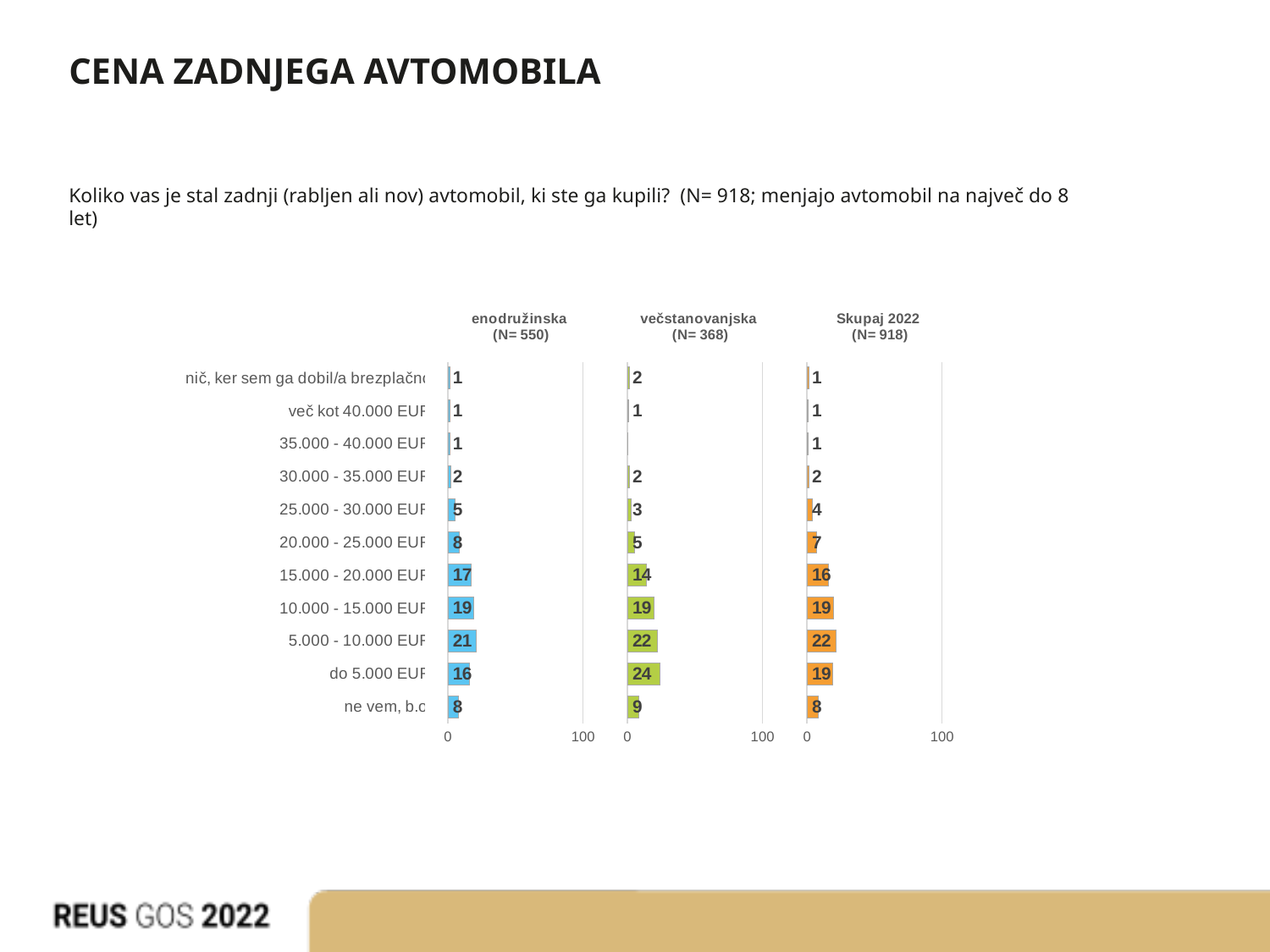
What kind of chart is used on this slide? bar chart In the Skupaj 2022 (N= 918) chart, what is the difference between the values for 5.000 - 10.000 EUR and 20.000 - 25.000 EUR? 15 How many categories are listed on the vertical axis of the charts? 11 In the enodružinska (N= 550) chart, what is the difference between the values for 10.000 - 15.000 EUR and do 5.000 EUR? 3 In the enodružinska (N= 550) chart, which category has the highest value? 5.000 - 10.000 EUR What is the sample size (N) shown in the heading of the Skupaj 2022 chart? N= 918 In the enodružinska (N= 550) chart, what is the value for 5.000 - 10.000 EUR? 21 Which is larger: the value for do 5.000 EUR in the enodružinska (N= 550) chart or in the večstanovanjska (N= 368) chart? večstanovanjska (N= 368) In the Skupaj 2022 (N= 918) chart, is the value for 5.000 - 10.000 EUR greater or less than 100? less In the Skupaj 2022 (N= 918) chart, what is the value for 15.000 - 20.000 EUR? 16 In the večstanovanjska (N= 368) chart, what is the value for do 5.000 EUR? 24 In the večstanovanjska (N= 368) chart, which category has the highest value? do 5.000 EUR